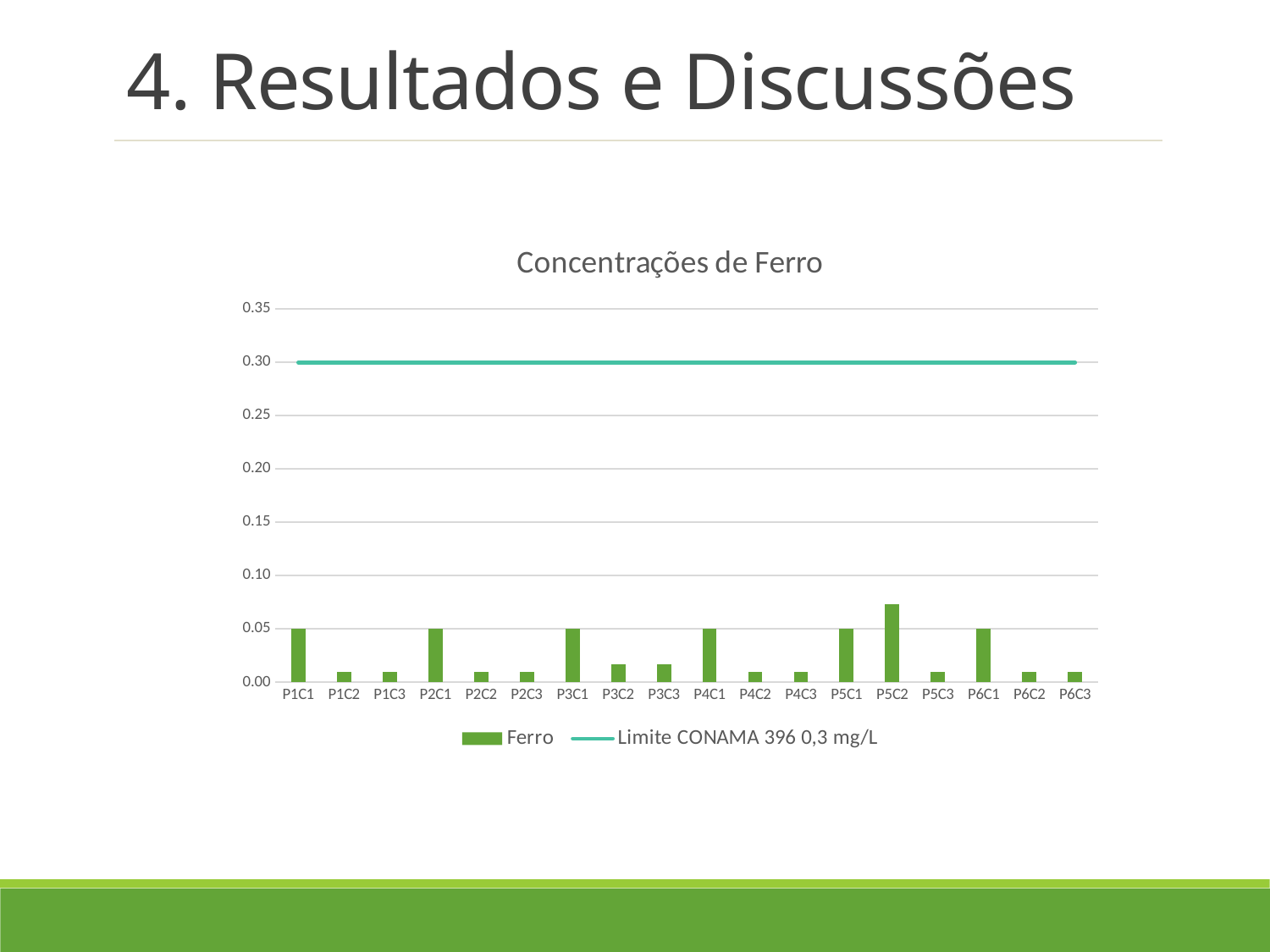
Which category has the highest Ferro value? P5C2 What is the name of the line series in the legend? Limite CONAMA 396 0,3 mg/L Which has the larger Ferro value, P5C1 or P5C2? P5C2 What kind of chart is used to show the Ferro values? bar chart What is the title of the chart? Concentrações de Ferro Is the Ferro value for P5C2 greater or less than 0.05? greater How many categories are shown on the x axis? 18 Which has the larger Ferro value, P1C1 or P1C2? P1C1 How many series does the legend list? 2 Is the Ferro value for P1C2 greater or less than 0.05? less At what value does the Limite CONAMA 396 line sit on the y axis? 0.30 Is the Ferro value for P5C2 greater or less than 0.30? less